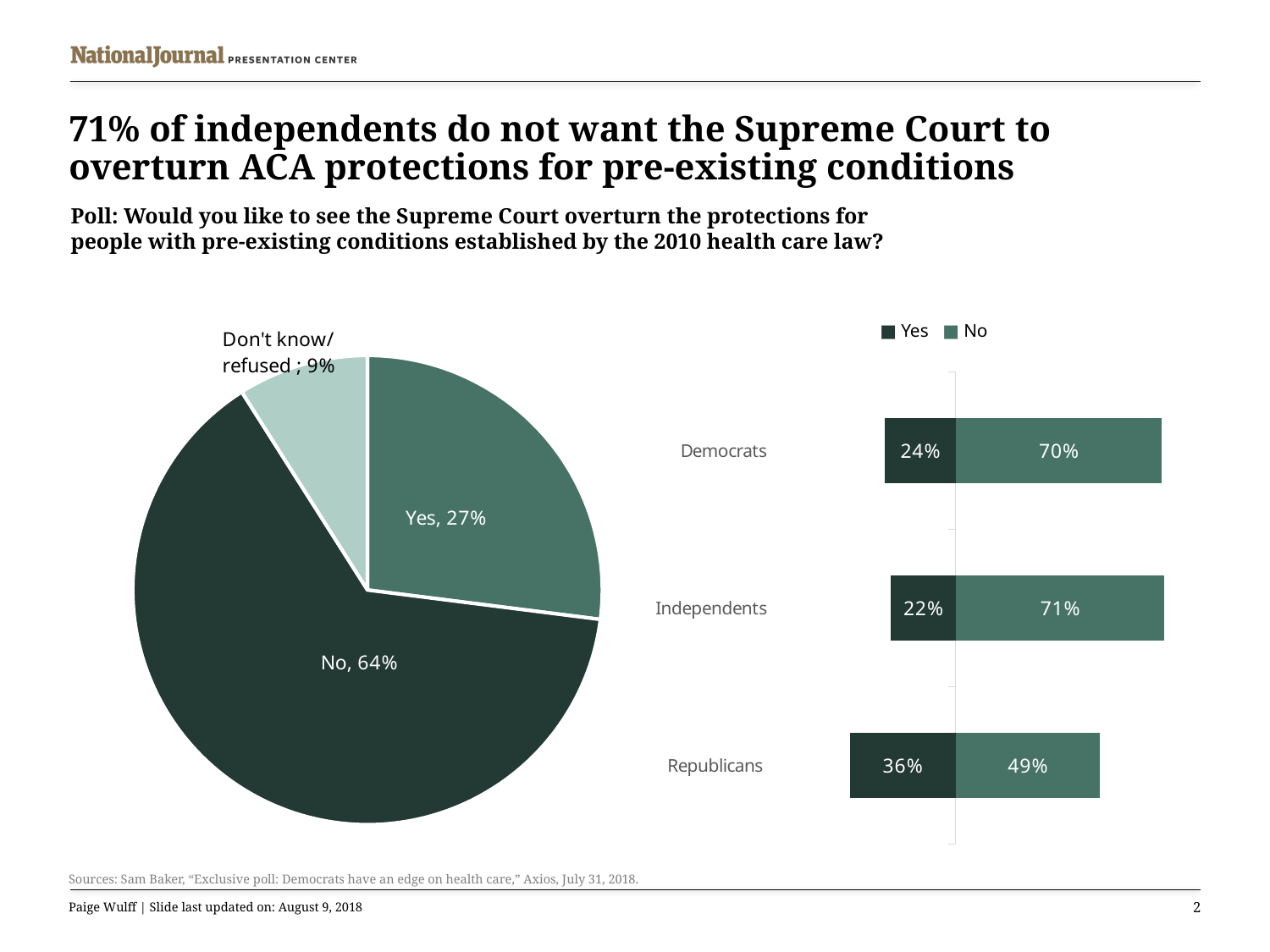
In the bar chart on the right, what is the difference between the "No" percentage for Democrats and for Republicans? 21% In the pie chart on the left, which response has the smallest slice? Don't know/refused In the pie chart on the left, what share of respondents answered "Yes"? 27% In the bar chart on the right, what percentage of Republicans answered "Yes"? 36% In the bar chart on the right, what percentage of Independents answered "No"? 71% In the bar chart on the right, which group has the highest "Yes" percentage? Republicans What type of chart is shown on the right side of the slide? Bar chart In the pie chart on the left, what share of respondents answered "Don't know/refused"? 9% In the pie chart on the left, how many slices are there? 3 In the pie chart on the left, what share of respondents answered "No"? 64% In the bar chart on the right, how many series does the legend list? 2 In the pie chart on the left, which response has the largest slice? No